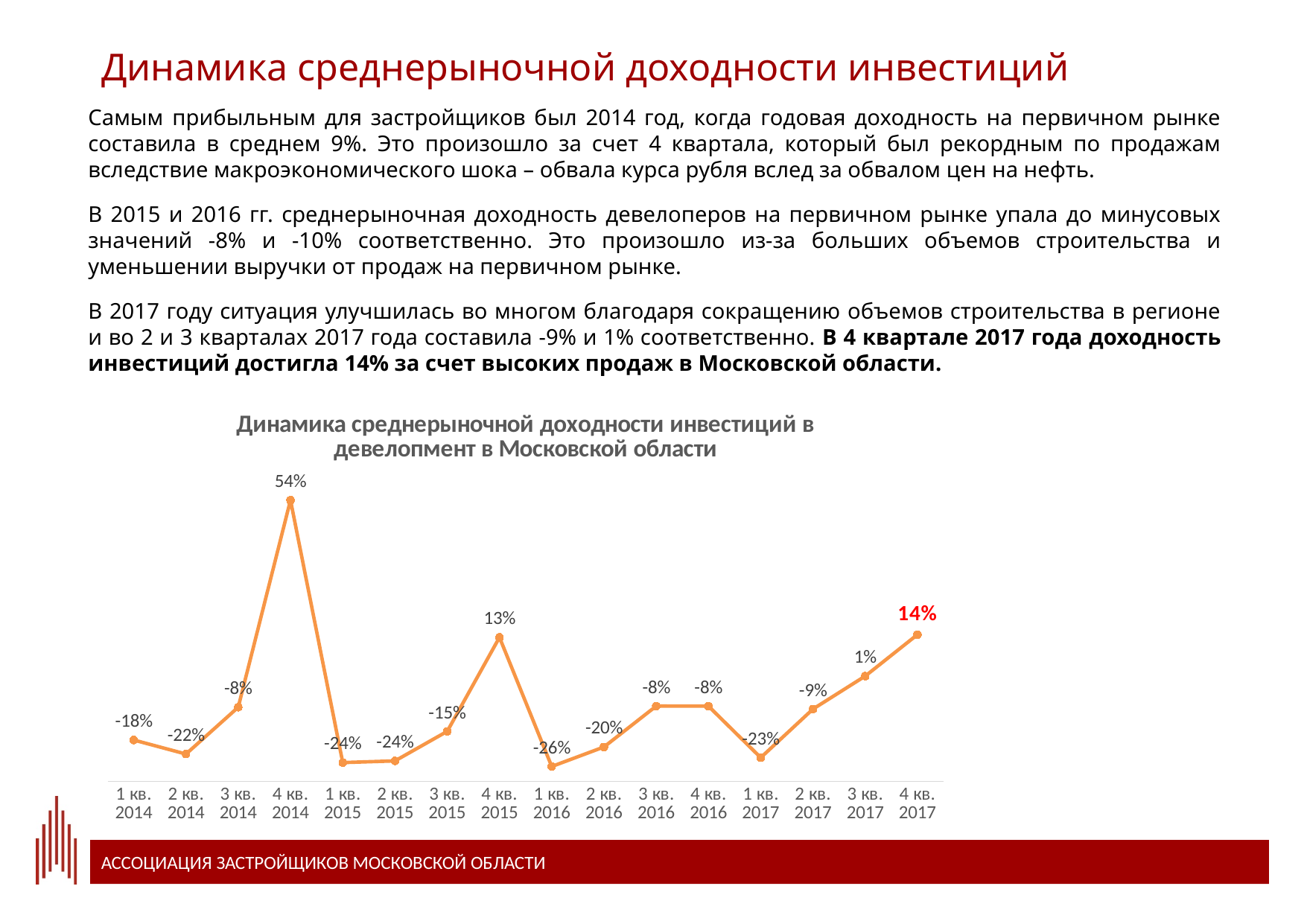
Which quarter has the lowest value? 1 кв. 2016 What is the difference between the values for 4 кв. 2017 and 3 кв. 2017? 13 percentage points What is the value for 1 кв. 2016? -26% Do the values rise or fall from 1 кв. 2017 to 4 кв. 2017? rise Which is larger, the value for 4 кв. 2015 or the value for 4 кв. 2017? 4 кв. 2017 What is the difference between the values for 4 кв. 2014 and 4 кв. 2015? 41 percentage points What is the value for 4 кв. 2017? 14% What type of chart is shown on the slide? line chart Which quarter has the highest value? 4 кв. 2014 How many quarters are plotted on the chart? 16 What is the value for 3 кв. 2017? 1% What is the value for 4 кв. 2014? 54%